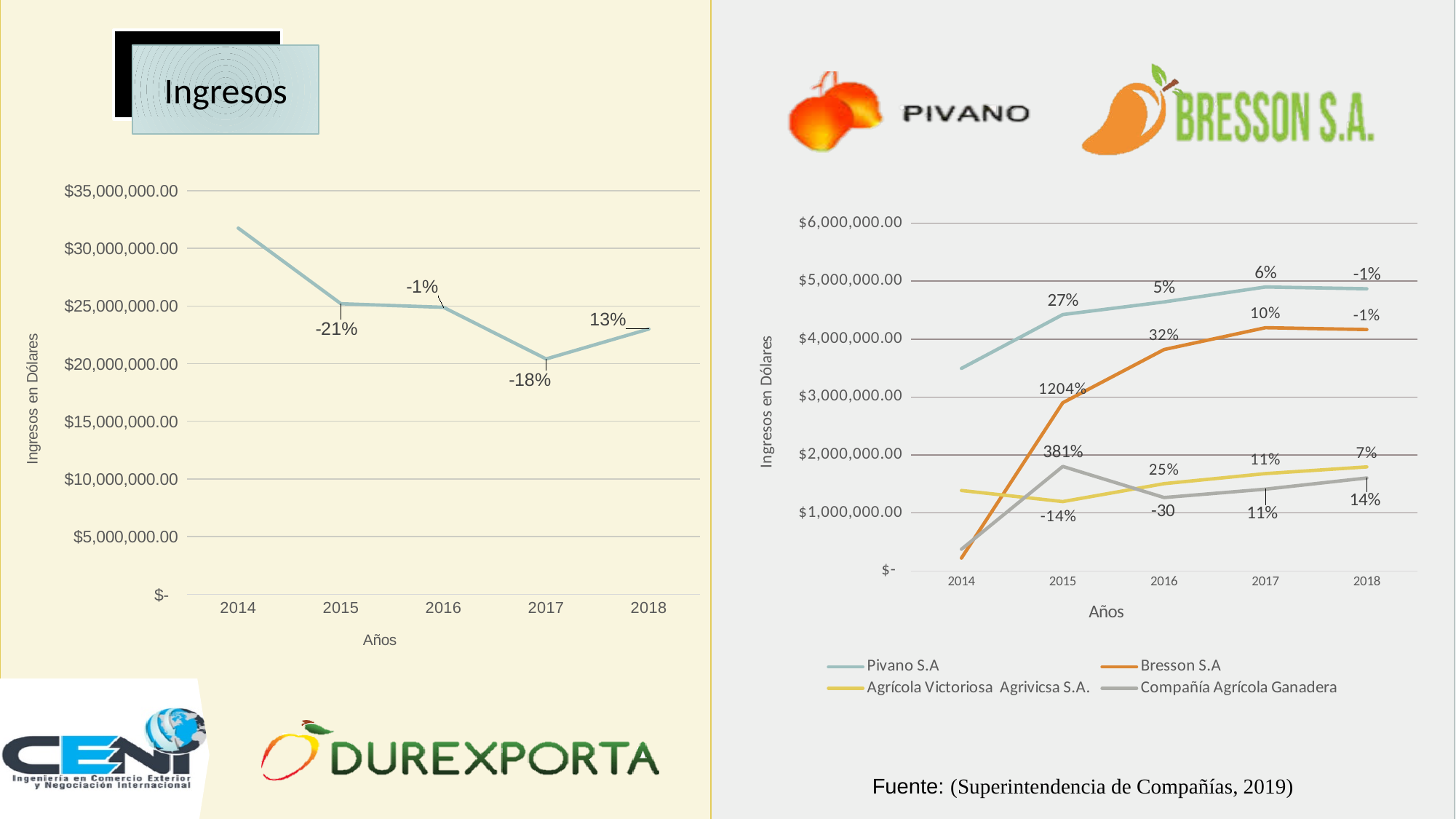
On the right chart, which series has the highest value in 2018? Pivano S.A On the right chart, how many series does the legend list? 4 On the left chart titled 'Ingresos', is the value for 2014 greater or less than $30,000,000.00? greater On the right chart, what percentage change is labelled for Bresson S.A in 2015? 1204% On the right chart, is the value for Bresson S.A in 2014 greater or less than $1,000,000.00? less What kind of chart is the left chart titled 'Ingresos'? line chart On the left chart titled 'Ingresos', how many years are plotted on the x axis? 5 On the left chart titled 'Ingresos', what percentage change is labelled for 2015? -21% On the left chart titled 'Ingresos', which year has the highest income? 2014 On the right chart, which is larger in 2016: Pivano S.A or Bresson S.A? Pivano S.A On the left chart titled 'Ingresos', which year has the lowest income? 2017 On the right chart, what percentage change is labelled for Pivano S.A in 2018? -1%